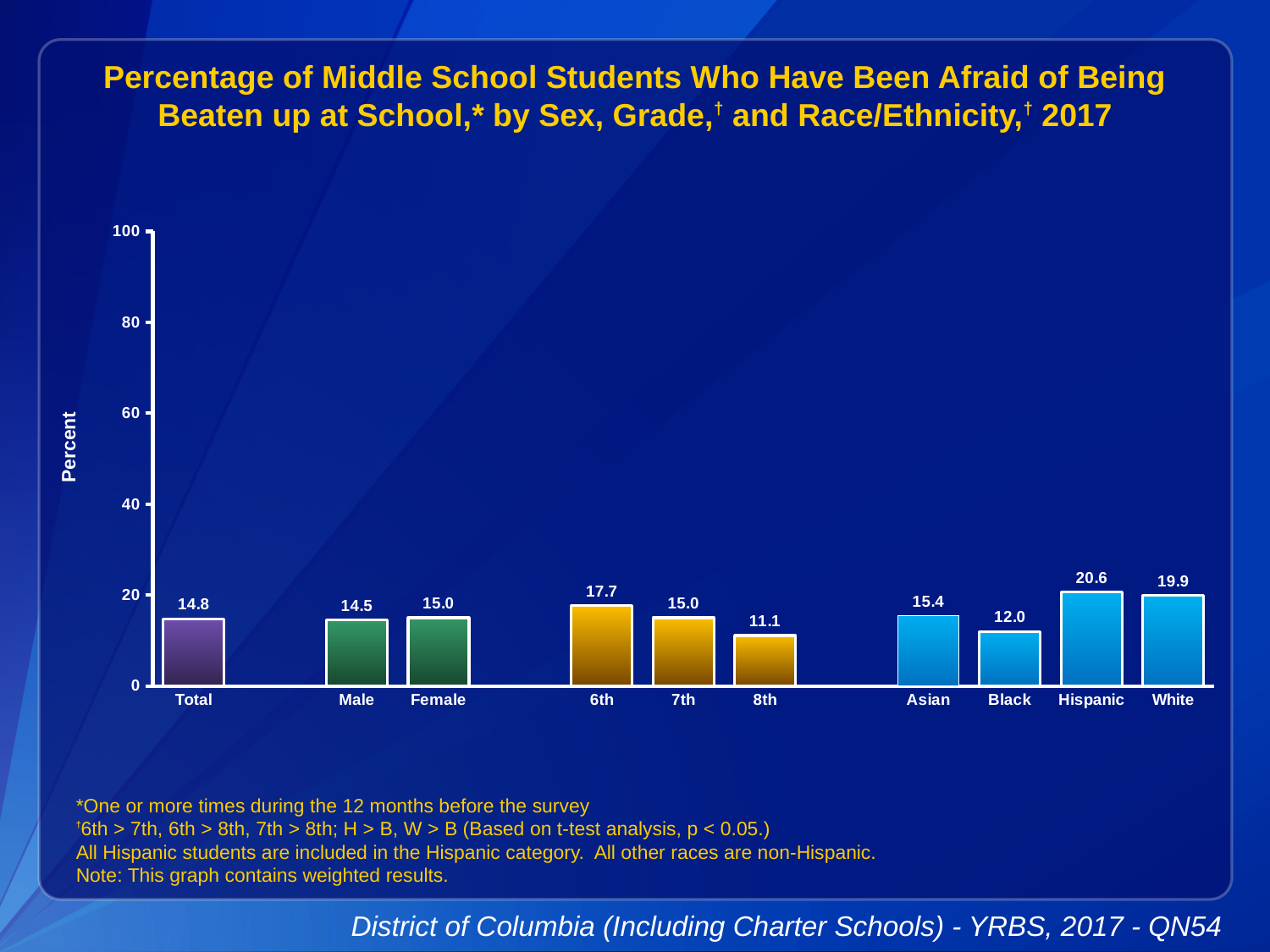
Which category has the lowest value? 8th Is the value for White greater or less than 20? less What is the value for Female? 15.0 What is the label on the y axis? Percent What is the value for 8th grade? 11.1 What kind of chart is this? bar chart What is the value for Hispanic? 20.6 What is the value for Total? 14.8 What is the difference between the values for 6th and 8th grade? 6.6 How many categories are shown on the x axis? 10 Which is larger, the value for Male or the value for Female? Female Which category has the highest value? Hispanic